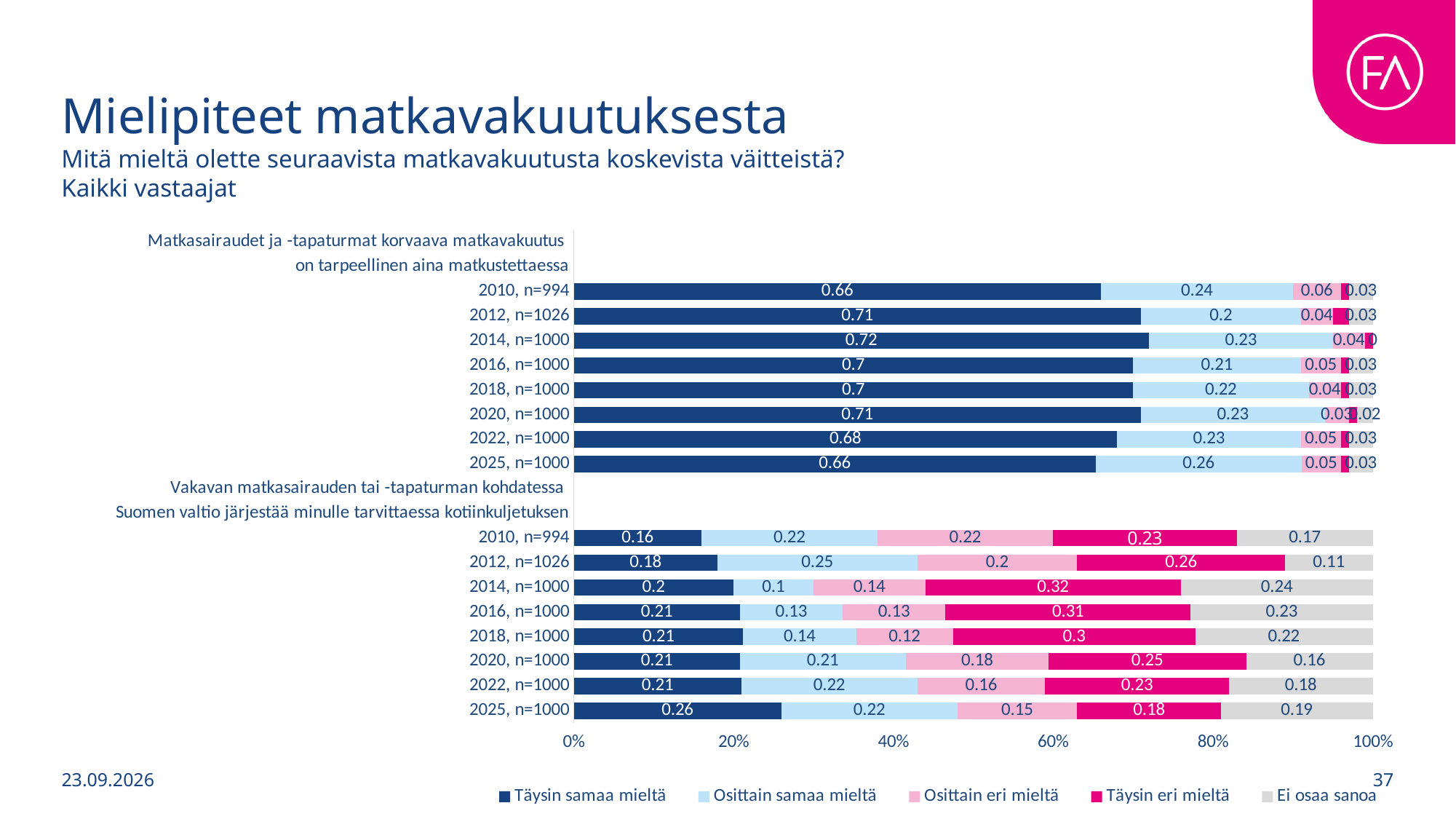
In the first statement group, which year has the highest Täysin samaa mieltä value? 2014, n=1000 In the first statement group (Matkasairaudet ja -tapaturmat korvaava matkavakuutus on tarpeellinen aina matkustettaessa), what is the Täysin samaa mieltä value for 2014, n=1000? 0.72 How many bars are plotted in the chart in total? 16 In the second statement group, what is the difference between the Täysin samaa mieltä values for 2025, n=1000 and 2010, n=994? 0.1 How many series does the legend list? 5 In the second statement group, what is the Ei osaa sanoa value for 2014, n=1000? 0.24 In the second statement group, which year has the lowest Täysin samaa mieltä value? 2010, n=994 What kind of chart is shown on the slide? Stacked bar chart In the first statement group, what is the Osittain samaa mieltä value for 2025, n=1000? 0.26 In the second statement group (Vakavan matkasairauden tai -tapaturman kohdatessa Suomen valtio järjestää minulle tarvittaessa kotiinkuljetuksen), what is the Täysin eri mieltä value for 2014, n=1000? 0.32 In the second statement group, does the Täysin eri mieltä value rise or fall from 2014 to 2025? Fall In the second statement group, which year has the larger Täysin eri mieltä value: 2016, n=1000 or 2018, n=1000? 2016, n=1000